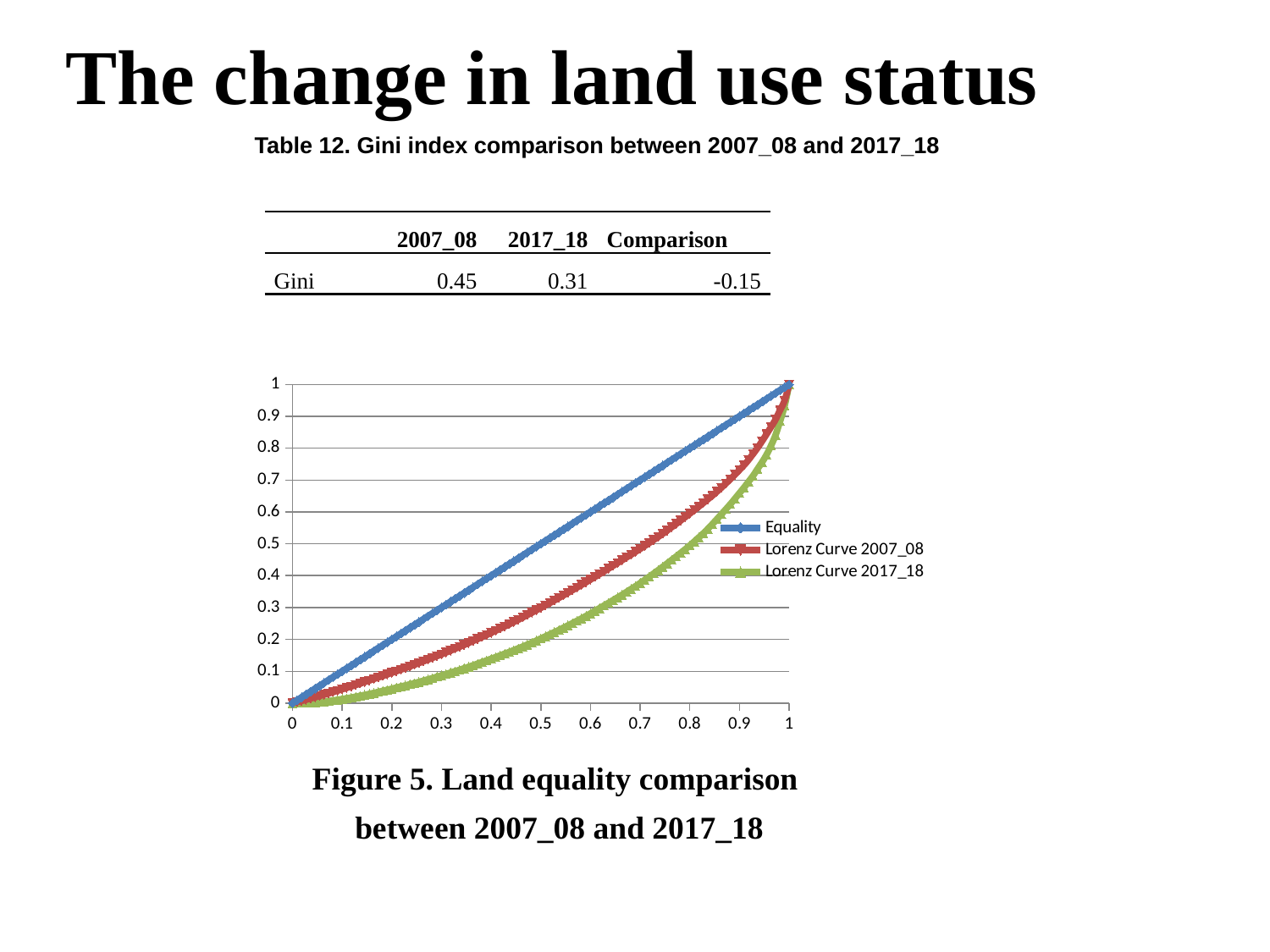
What kind of chart is shown in Figure 5? line chart Which series in the chart is the lowest across the middle of the x axis? Lorenz Curve 2017_18 Which series are listed in the chart's legend? Equality, Lorenz Curve 2007_08, Lorenz Curve 2017_18 Do the values of the Lorenz Curve 2007_08 series rise or fall as the x axis increases? rise At x = 0.5, is the value of Lorenz Curve 2007_08 greater or less than 0.4? less At x = 0.5, which series is higher: Equality or Lorenz Curve 2017_18? Equality How many series does the legend of the chart list? 3 At x = 0.5, which series is higher: Lorenz Curve 2007_08 or Lorenz Curve 2017_18? Lorenz Curve 2007_08 At x = 0.5, is the value of Lorenz Curve 2017_18 greater or less than 0.3? less At x = 0.8, is the value of Lorenz Curve 2017_18 greater or less than 0.6? less What colour is the Lorenz Curve 2017_18 line in the chart? green